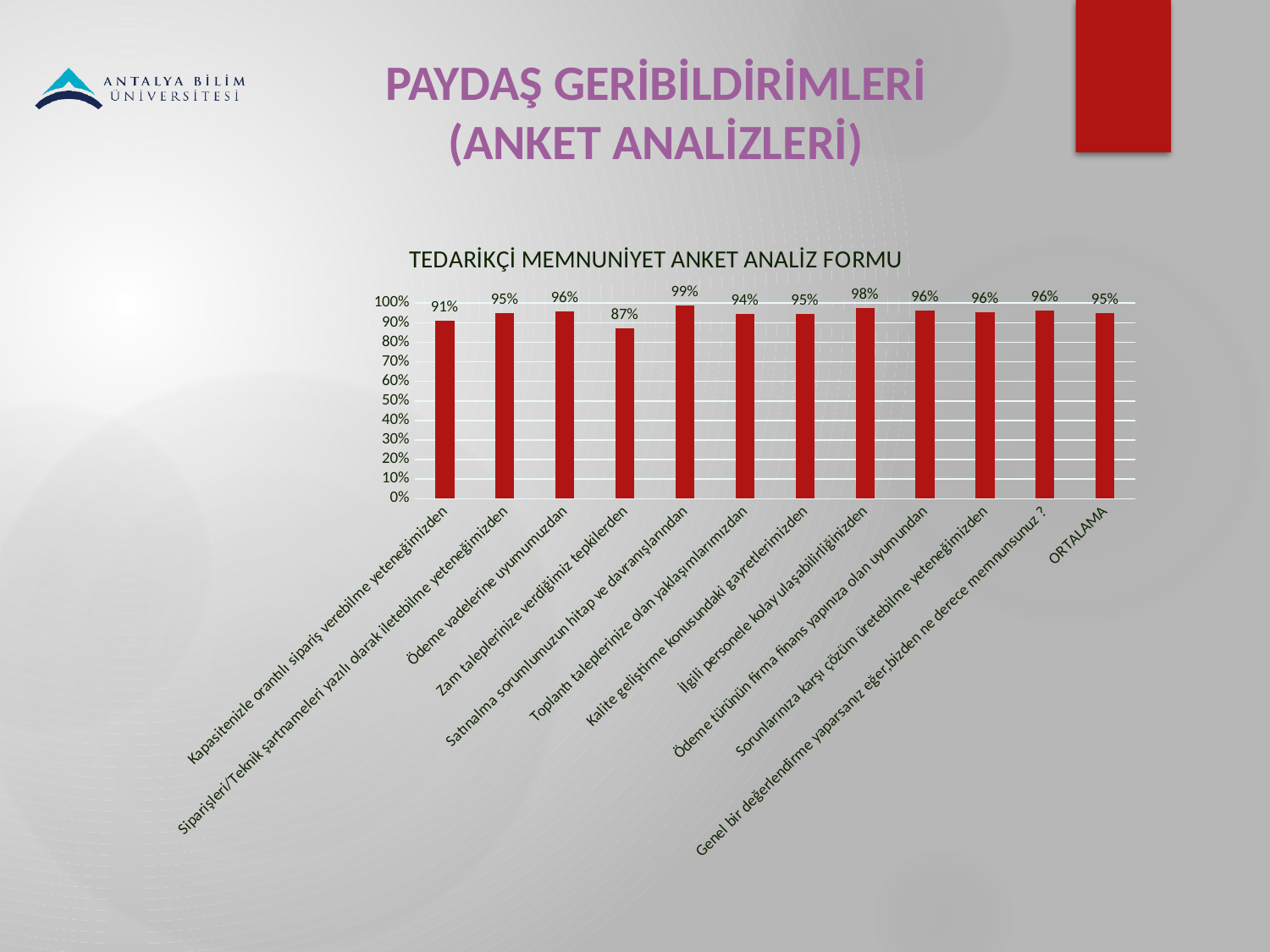
What type of chart is shown on the slide? Bar chart How many categories are shown on the x axis? 12 What is the value for 'Kapasitenizle orantılı sipariş verebilme yeteneğimizden'? 91% What is the value for ORTALAMA? 95% What is the title of the chart? TEDARİKÇİ MEMNUNİYET ANKET ANALİZ FORMU Which category has the highest value? Satınalma sorumlumuzun hitap ve davranışlarından What is the value for 'Satınalma sorumlumuzun hitap ve davranışlarından'? 99% Which category has the lowest value? Zam taleplerinize verdiğimiz tepkilerden What is the difference between the values for 'Satınalma sorumlumuzun hitap ve davranışlarından' and 'Zam taleplerinize verdiğimiz tepkilerden'? 12% What is the value for 'Ödeme vadelerine uyumumuzdan'? 96% Which is larger: the value for 'İlgili personele kolay ulaşabilirliğinizden' or the value for 'Toplantı taleplerinize olan yaklaşımlarımızdan'? İlgili personele kolay ulaşabilirliğinizden What is the value for 'Zam taleplerinize verdiğimiz tepkilerden'? 87%